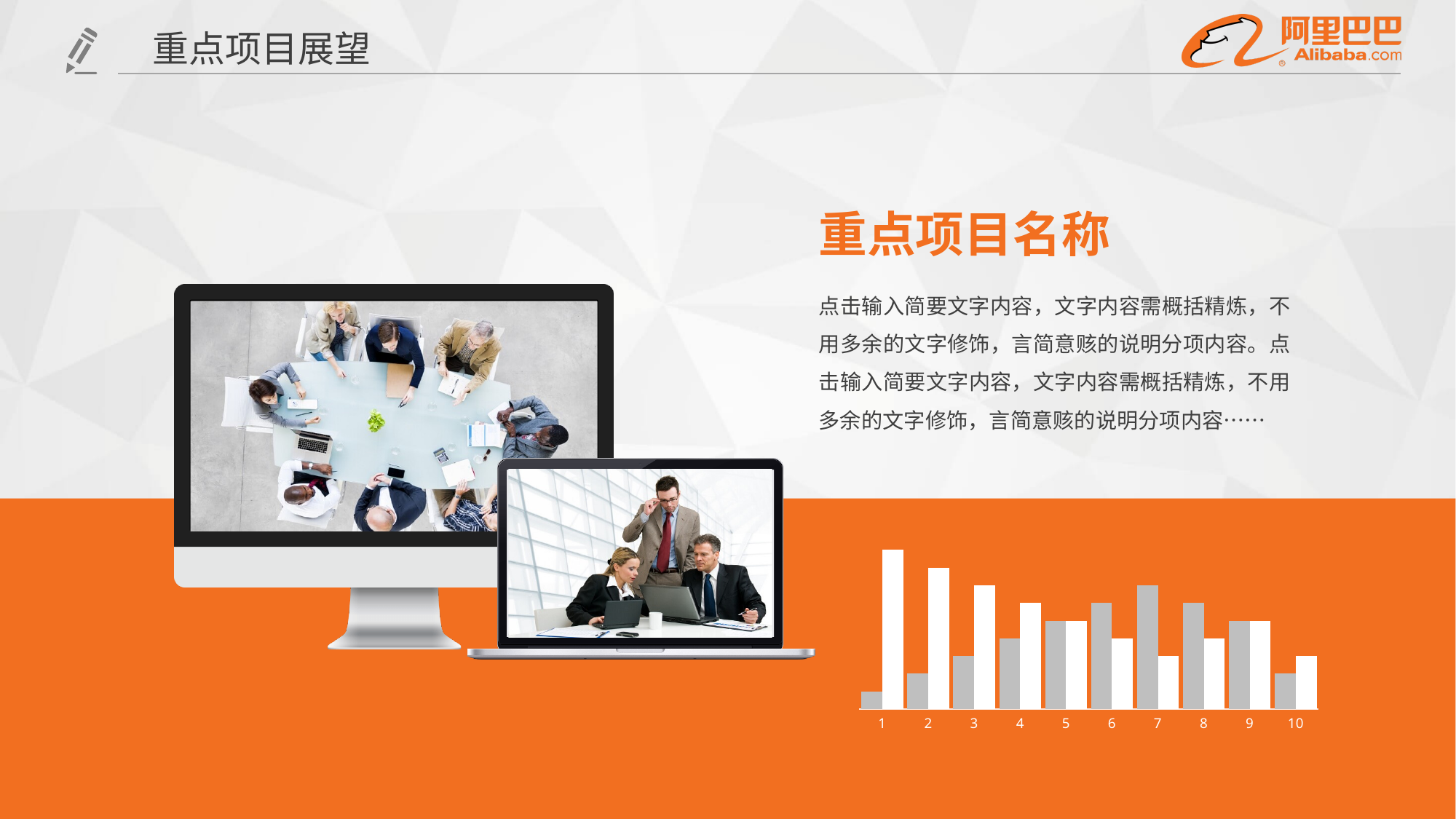
What two colours are the bars in the chart? white and gray Is the white bar for category 1 taller or shorter than the white bar for category 10? taller Is the gray bar for category 7 taller or shorter than the gray bar for category 2? taller Which category has the tallest white bar? 1 How many categories are shown on the x axis of the bar chart? 10 Do the white bars rise or fall from category 1 to category 10? fall In category 1, which bar is taller, the white one or the gray one? the white one Which category has the tallest gray bar? 7 What kind of chart is shown at the bottom right of the slide? bar chart How many bars are plotted for each category in the bar chart? 2 Which category has the shortest gray bar? 1